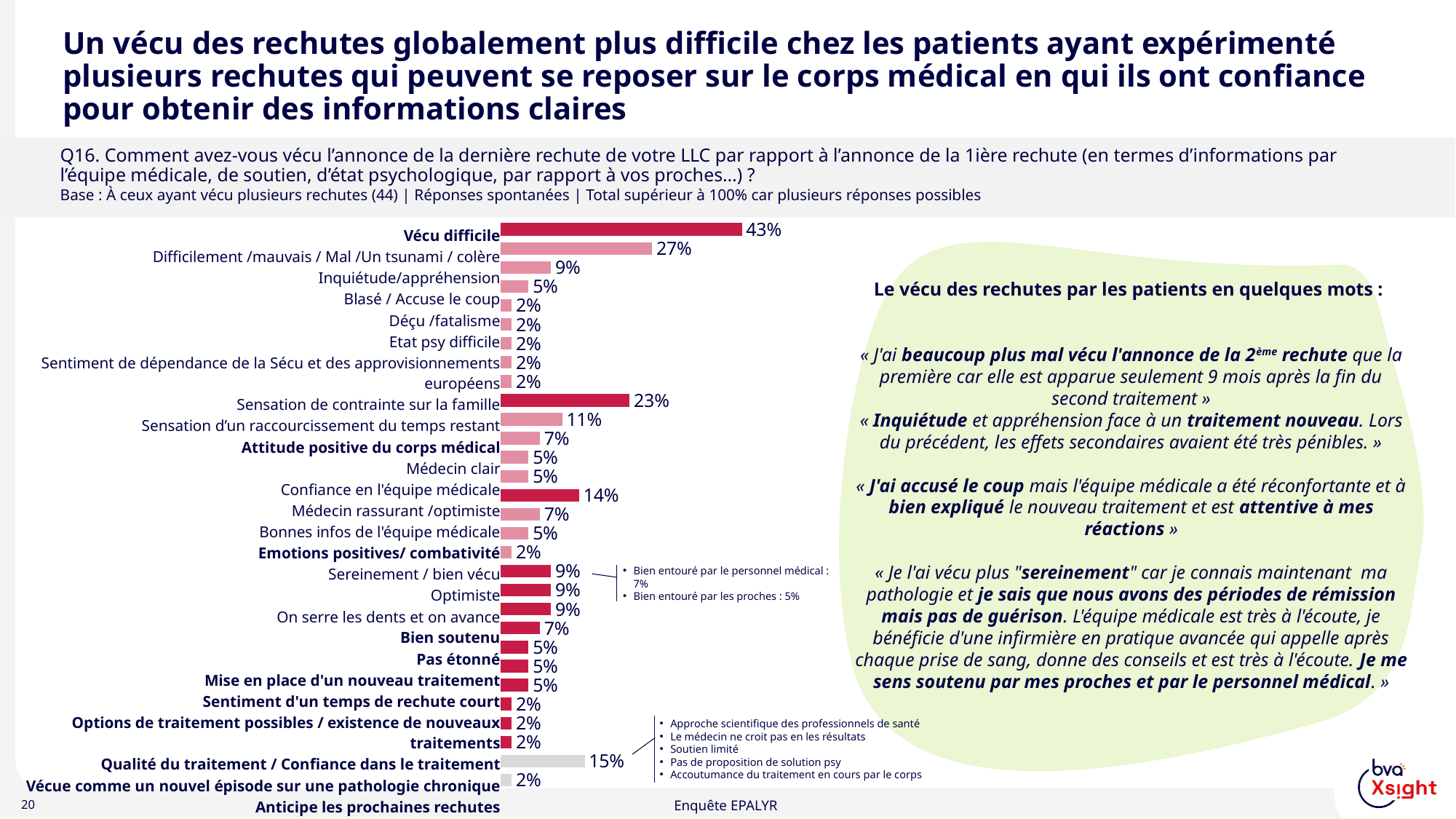
Which category has the highest value in the chart? Vécu difficile What is the value of the longest grey bar in the chart? 15% Which is larger: the value for 'Vécu difficile' or for 'Difficilement /mauvais / Mal /Un tsunami / colère'? Vécu difficile What type of chart is shown on the slide? Bar chart What is the smallest percentage value shown on the chart? 2% According to the callout next to the chart, what percentage is given for 'Bien entouré par le personnel médical'? 7% What is the value for 'Difficilement /mauvais / Mal /Un tsunami / colère'? 27% According to the callout next to the chart, what percentage is given for 'Bien entouré par les proches'? 5% What is the difference between the values for 'Vécu difficile' and 'Difficilement /mauvais / Mal /Un tsunami / colère'? 16 percentage points How many respondents form the base for this chart? 44 What is the value for 'Vécu difficile'? 43% Which question number does the chart report on? Q16